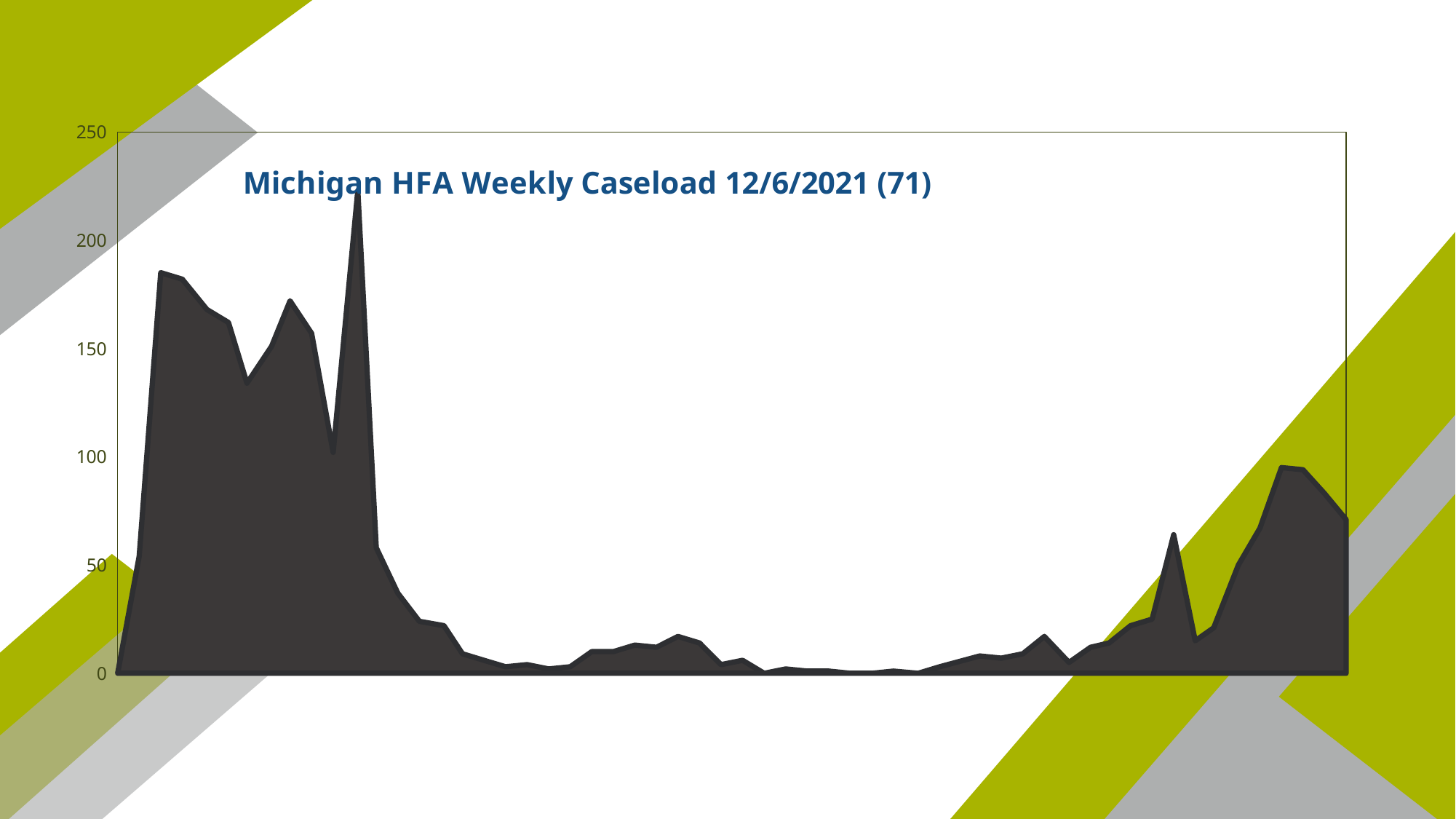
Is the tallest peak of the chart greater or less than 250? less What is the highest value shown on the vertical axis? 250 Is the small spike just before the final rise on the right greater or less than 100? less What is the title of the chart? Michigan HFA Weekly Caseload 12/6/2021 (71) Is the tallest peak of the chart greater or less than 200? greater Do the values rise or fall from the tallest peak toward the middle of the chart? fall What kind of chart is shown on the slide? area chart Do the values rise or fall over the last section of the chart compared with the flat middle section? rise